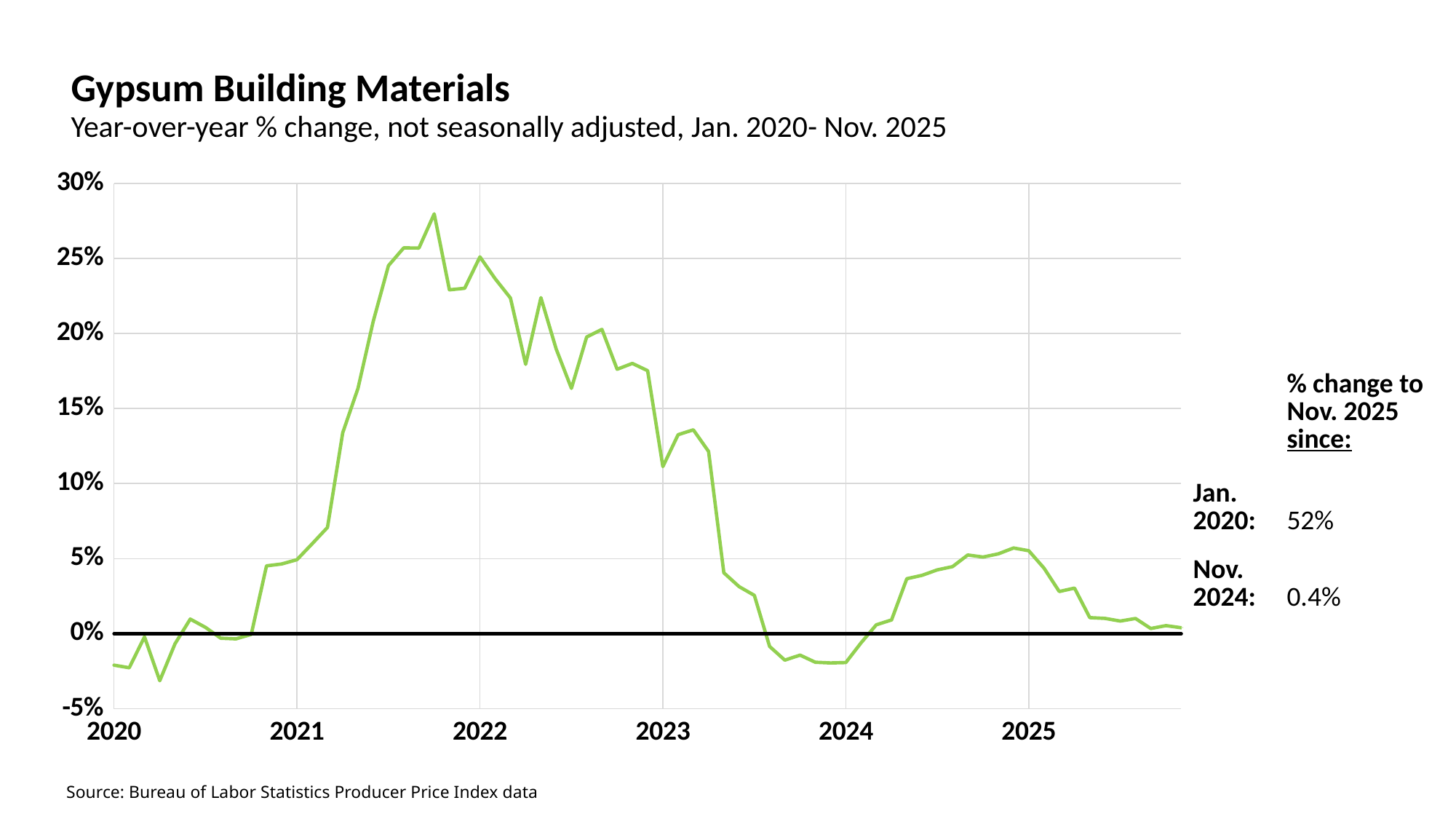
Is the value at the start of 2024 greater or less than 0%? less What is the source cited for the chart data? Bureau of Labor Statistics Producer Price Index data Is the value at the start of 2020 greater or less than 0%? less In which year does the line reach its highest value? 2021 What kind of chart is shown on the slide? line chart According to the annotation, what is the % change to Nov. 2025 since Nov. 2024? 0.4% What is the title of the chart? Gypsum Building Materials Is the peak value of the line greater or less than 25%? greater Between the start of 2022 and the start of 2024, does the line generally rise or fall? fall According to the annotation, what is the % change to Nov. 2025 since Jan. 2020? 52%